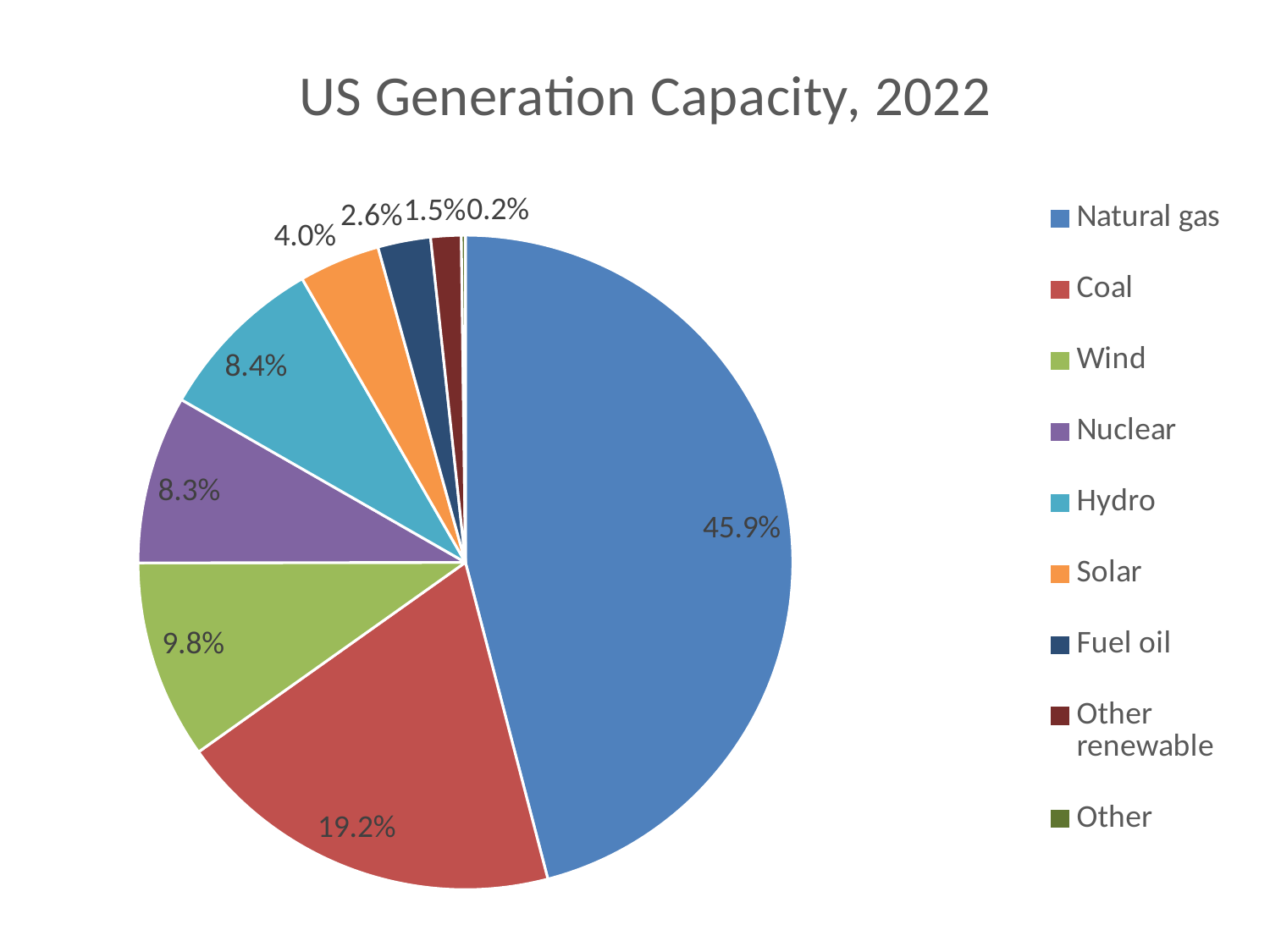
Which category has the largest share of the pie? Natural gas What is the difference in percentage points between Natural gas and Coal? 26.7 What type of chart is shown on the slide? Pie chart Which category has the smallest share of the pie? Other What share of US generation capacity is Solar? 4.0% What is the title of the chart? US Generation Capacity, 2022 What share of US generation capacity is Fuel oil? 2.6% What share of US generation capacity is Wind? 9.8% Which has a larger share, Wind or Solar? Wind How many categories does the legend list? 9